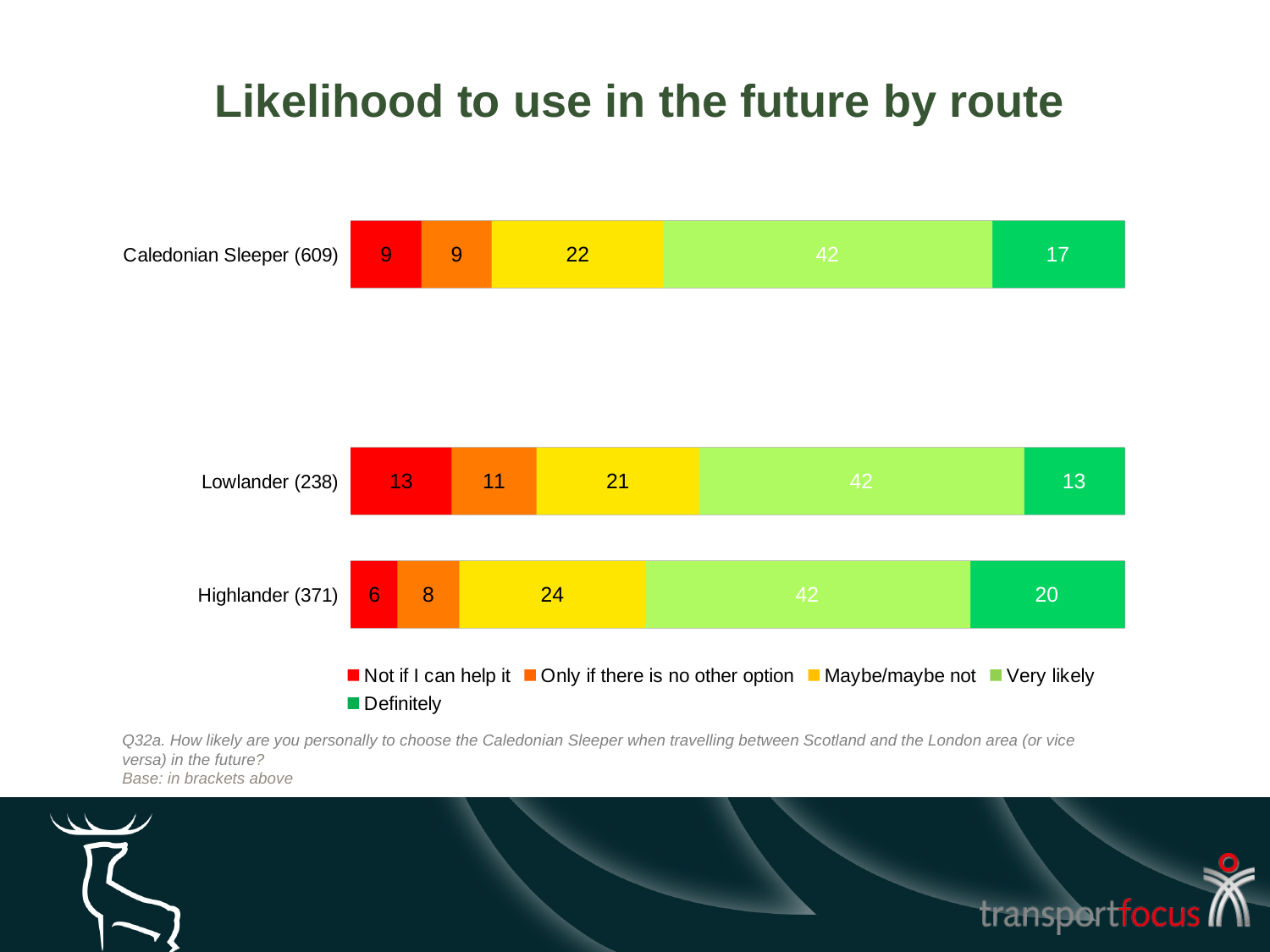
What is the 'Definitely' value for Highlander (371)? 20 What is the 'Not if I can help it' value for Lowlander (238)? 13 How many series does the legend list? 5 Which route has the highest 'Definitely' value? Highlander (371) Which route has the lowest 'Not if I can help it' value? Highlander (371) What kind of chart is shown on the slide? Stacked bar chart How many routes are shown in the chart? 3 What is the difference between the 'Definitely' values for Highlander (371) and Lowlander (238)? 7 Is the 'Only if there is no other option' value larger for Lowlander (238) or Highlander (371)? Lowlander (238) What is the 'Maybe/maybe not' value for Caledonian Sleeper (609)? 22 What is the title of the chart? Likelihood to use in the future by route What is the total of the stacked bar for Lowlander (238)? 100